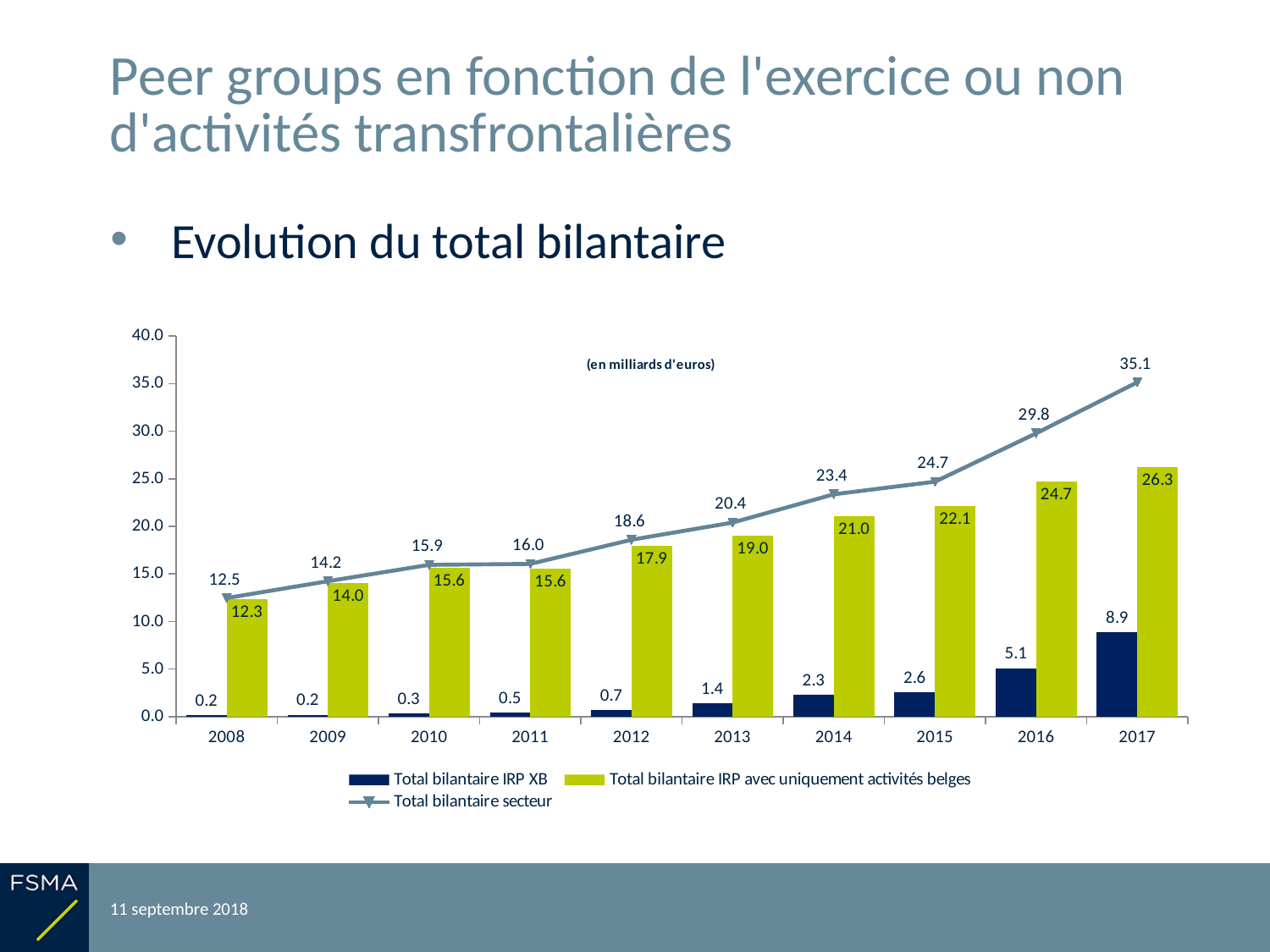
What unit is stated on the chart? en milliards d'euros How many years are shown on the x axis? 10 Which is larger: Total bilantaire IRP XB in 2016 or in 2015? 2016 Which series is drawn as a line rather than bars? Total bilantaire secteur What is the value of Total bilantaire IRP avec uniquement activités belges in 2013? 19.0 Does Total bilantaire secteur rise or fall from 2008 to 2017? rise In which year is Total bilantaire IRP avec uniquement activités belges lowest? 2008 How many series does the legend list? 3 What is the value of Total bilantaire IRP XB in 2017? 8.9 In which year is Total bilantaire secteur highest? 2017 What is the value of Total bilantaire secteur in 2014? 23.4 What is the difference between Total bilantaire secteur in 2017 and in 2016? 5.3